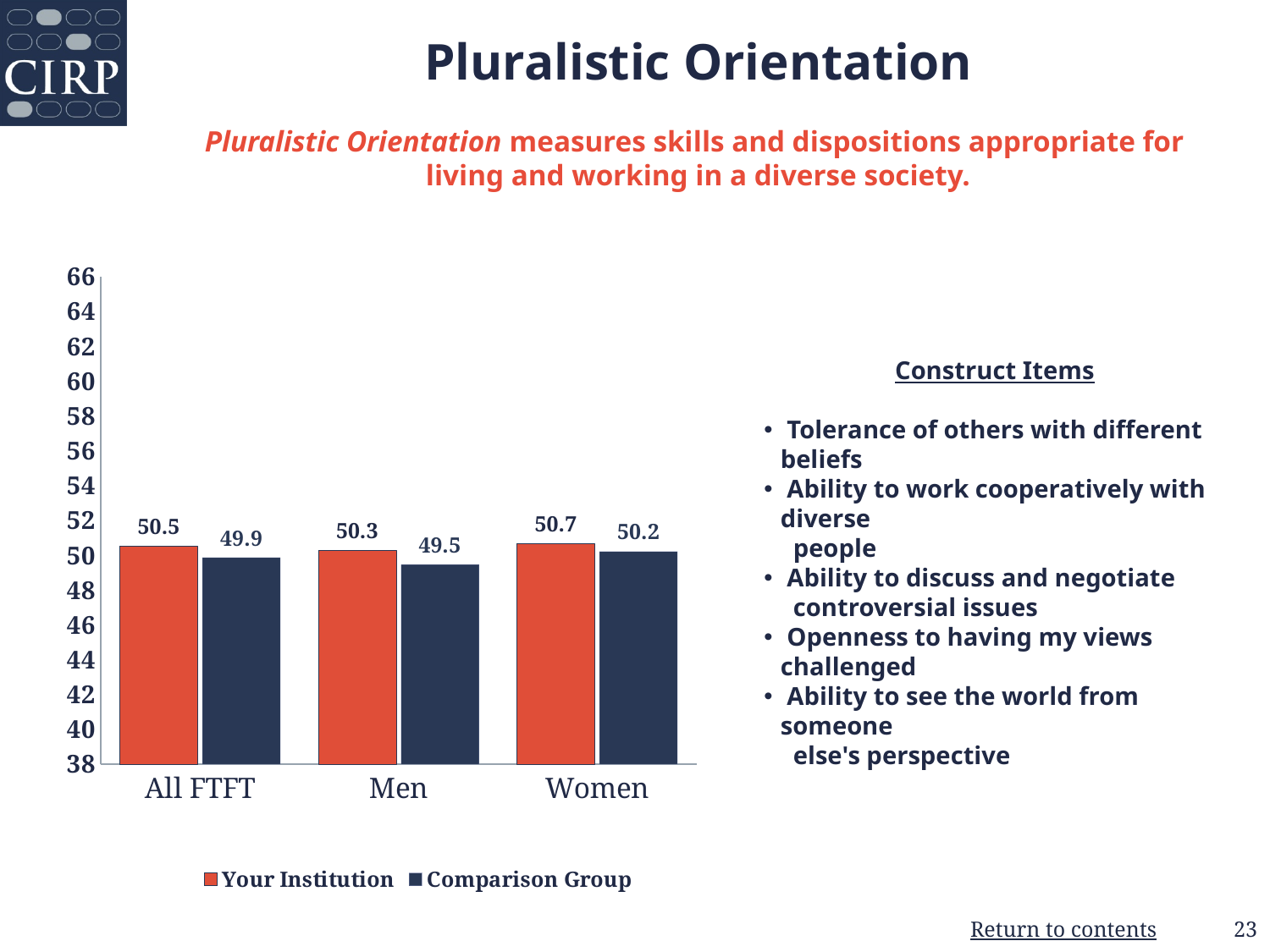
Which series is shown in orange-red in the legend? Your Institution What is the value for Your Institution in the All FTFT category? 50.5 What is the value for Your Institution in the Women category? 50.7 What is the value for the Comparison Group in the Men category? 49.5 How many categories are shown on the x axis? 3 In the All FTFT category, which is larger: Your Institution or the Comparison Group? Your Institution What is the difference between Your Institution and the Comparison Group in the Men category? 0.8 Which category has the lowest value for the Comparison Group? Men How many series does the legend list? 2 What kind of chart is shown on the slide? Bar chart What is the value for the Comparison Group in the Women category? 50.2 Which category has the highest value for Your Institution? Women